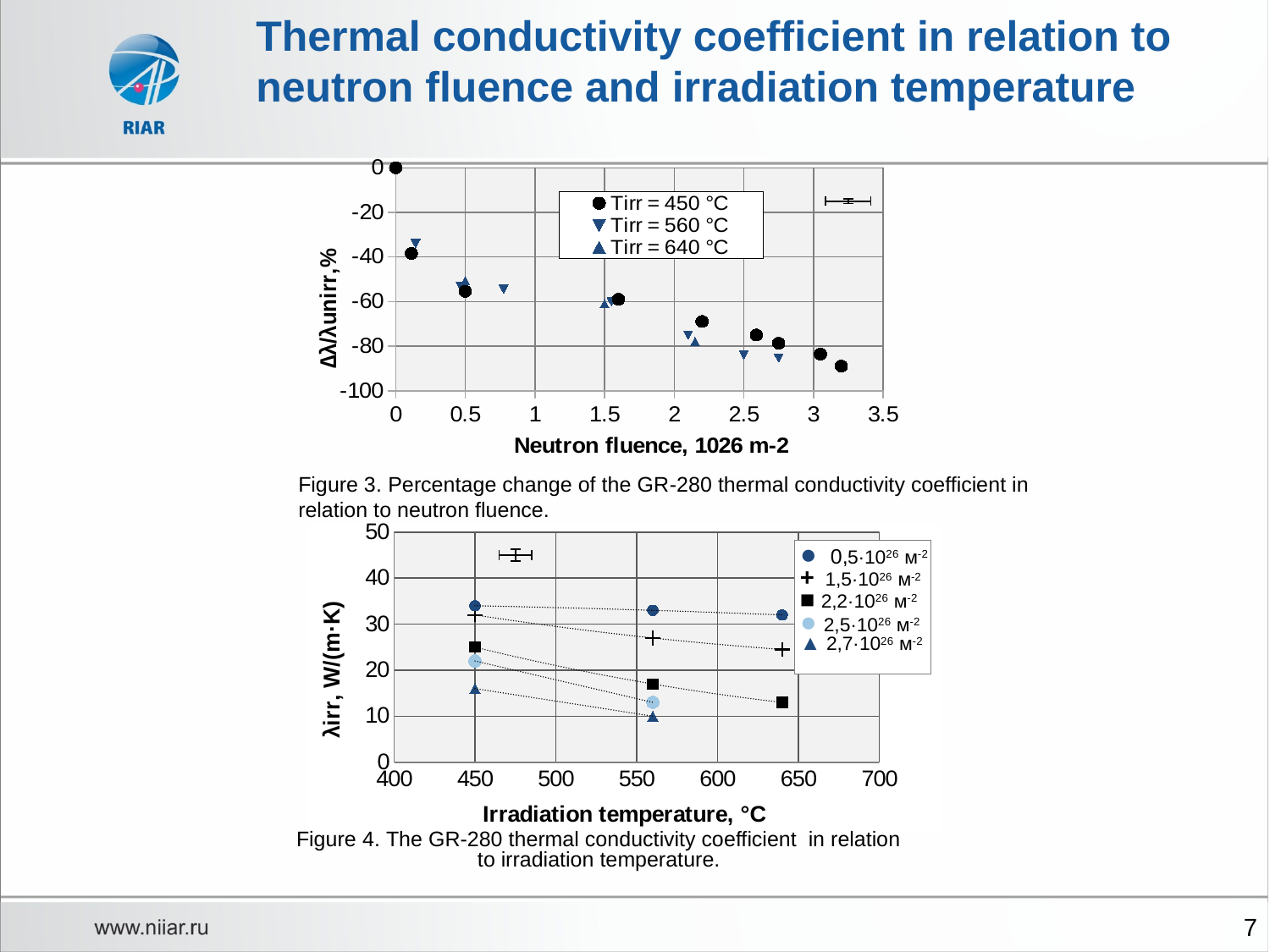
In Figure 3 (top chart), what is the value for Tirr = 450 °C at a neutron fluence of 0? 0 In Figure 3 (top chart), how many series does the legend list? 3 In Figure 4 (bottom chart), how many data points are plotted for the 2,2·10^26 m^-2 series? 3 In Figure 3 (top chart), is the value for Tirr = 450 °C at the highest neutron fluence (about 3.2) greater or less than -80? less In Figure 3 (top chart), is the value for Tirr = 560 °C at a neutron fluence of about 0.75 greater or less than -60? greater In Figure 4 (bottom chart), is the value for the 0,5·10^26 m^-2 series at 450 °C greater or less than 30? greater In Figure 3 (top chart), do the values for Tirr = 450 °C rise or fall as neutron fluence increases? fall In Figure 4 (bottom chart), how many series does the legend list? 5 What kind of chart is Figure 3 (top chart)? scatter chart What is the x-axis label of Figure 4 (bottom chart)? Irradiation temperature, °C In Figure 4 (bottom chart), do the values for the 2,2·10^26 m^-2 series rise or fall as irradiation temperature increases? fall